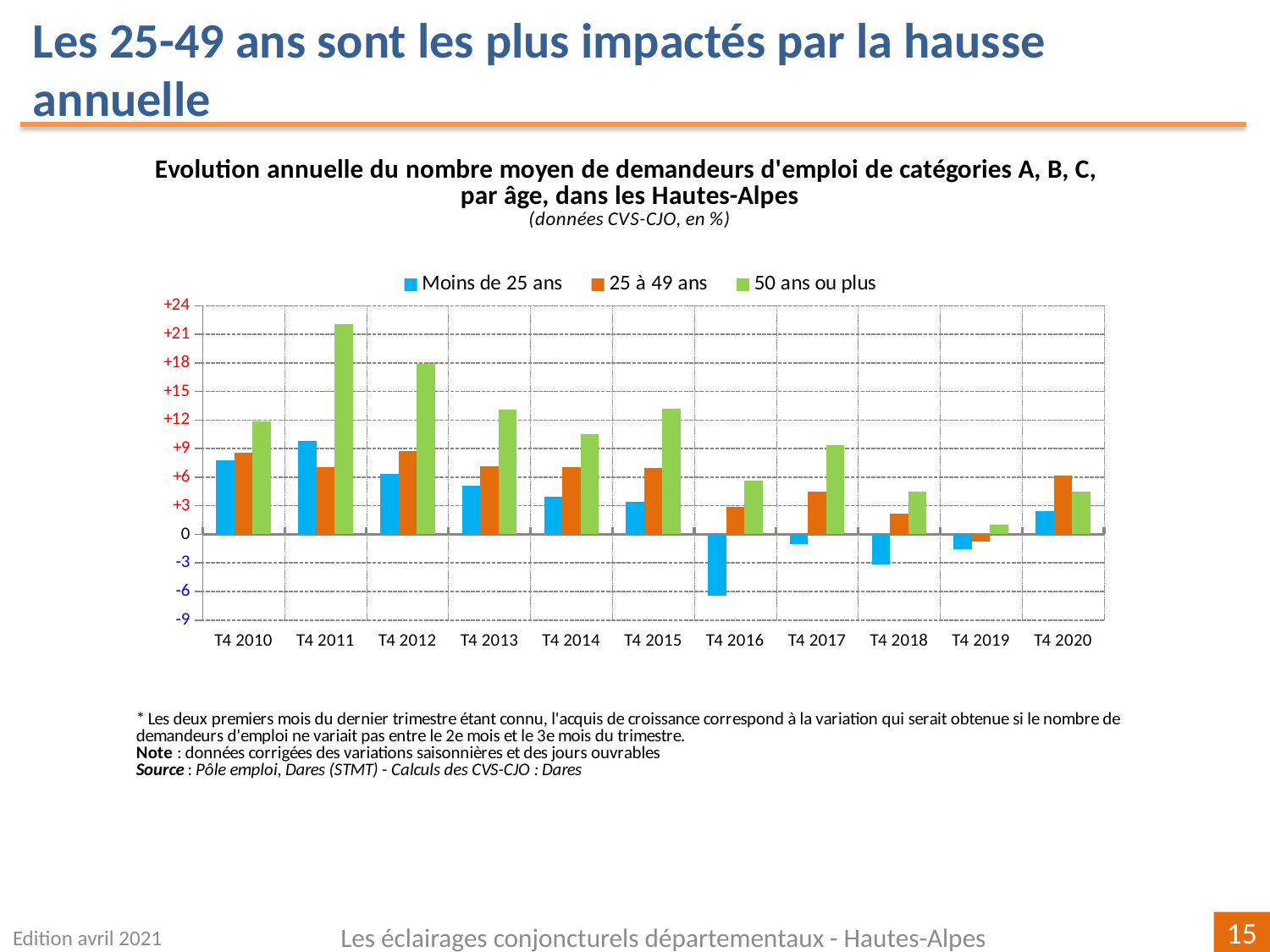
What kind of chart is shown on the slide? Bar chart Is the value for '50 ans ou plus' in T4 2017 greater or less than +6? greater Is the value for '50 ans ou plus' in T4 2011 greater or less than +18? greater Does the value for 'Moins de 25 ans' rise or fall from T4 2011 to T4 2016? fall What colour represents the '25 à 49 ans' series in the legend? Orange In which quarter is the value for 'Moins de 25 ans' the lowest? T4 2016 Is the value for 'Moins de 25 ans' in T4 2016 greater or less than -3? less How many quarters (categories) are shown on the x axis? 11 In which quarter is the value for '50 ans ou plus' the highest? T4 2011 In T4 2020, which is larger: the value for '25 à 49 ans' or for '50 ans ou plus'? 25 à 49 ans In T4 2012, which is larger: the value for '50 ans ou plus' or for 'Moins de 25 ans'? 50 ans ou plus How many series does the legend list? 3